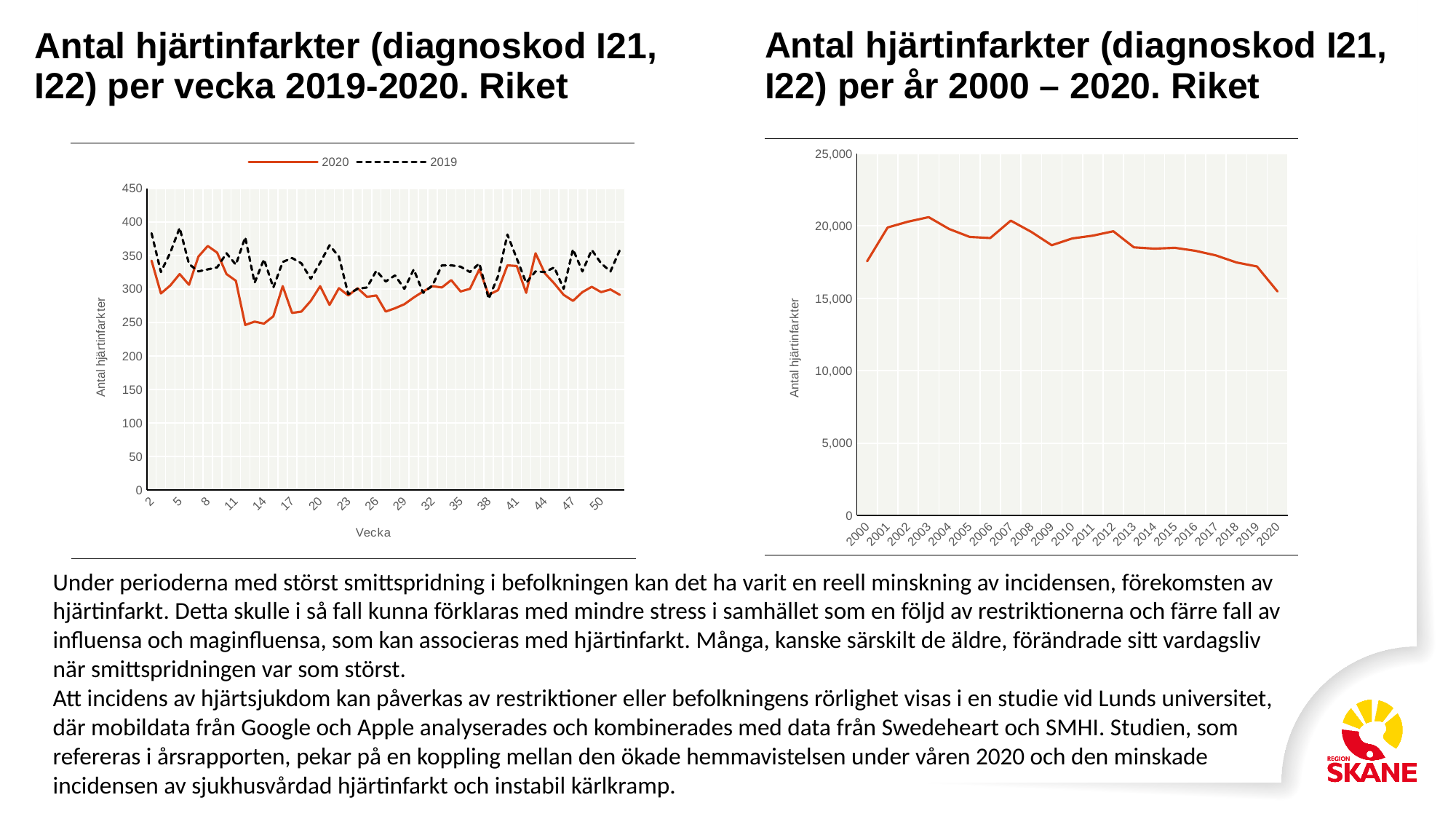
In the right chart (per år 2000 – 2020), which is larger, the value for 2003 or the value for 2020? 2003 In the left chart (per vecka 2019-2020), is the 2020 value for week 14 greater or less than 300? less What kind of chart is the left chart, 'Antal hjärtinfarkter (diagnoskod I21, I22) per vecka 2019-2020. Riket'? line chart In the right chart (per år 2000 – 2020), which year has the lowest value? 2020 In the left chart (per vecka 2019-2020), how many series does the legend list? 2 In the right chart (per år 2000 – 2020), do the values rise or fall from 2012 to 2020? fall In the left chart (per vecka 2019-2020), which series is drawn as a dashed line? 2019 In the right chart (per år 2000 – 2020), is the value for 2000 greater or less than 20,000? less What kind of chart is the right chart, 'Antal hjärtinfarkter (diagnoskod I21, I22) per år 2000 – 2020. Riket'? line chart In the right chart (per år 2000 – 2020), is the value for 2003 greater or less than 20,000? greater In the right chart (per år 2000 – 2020), how many years are shown on the x axis? 21